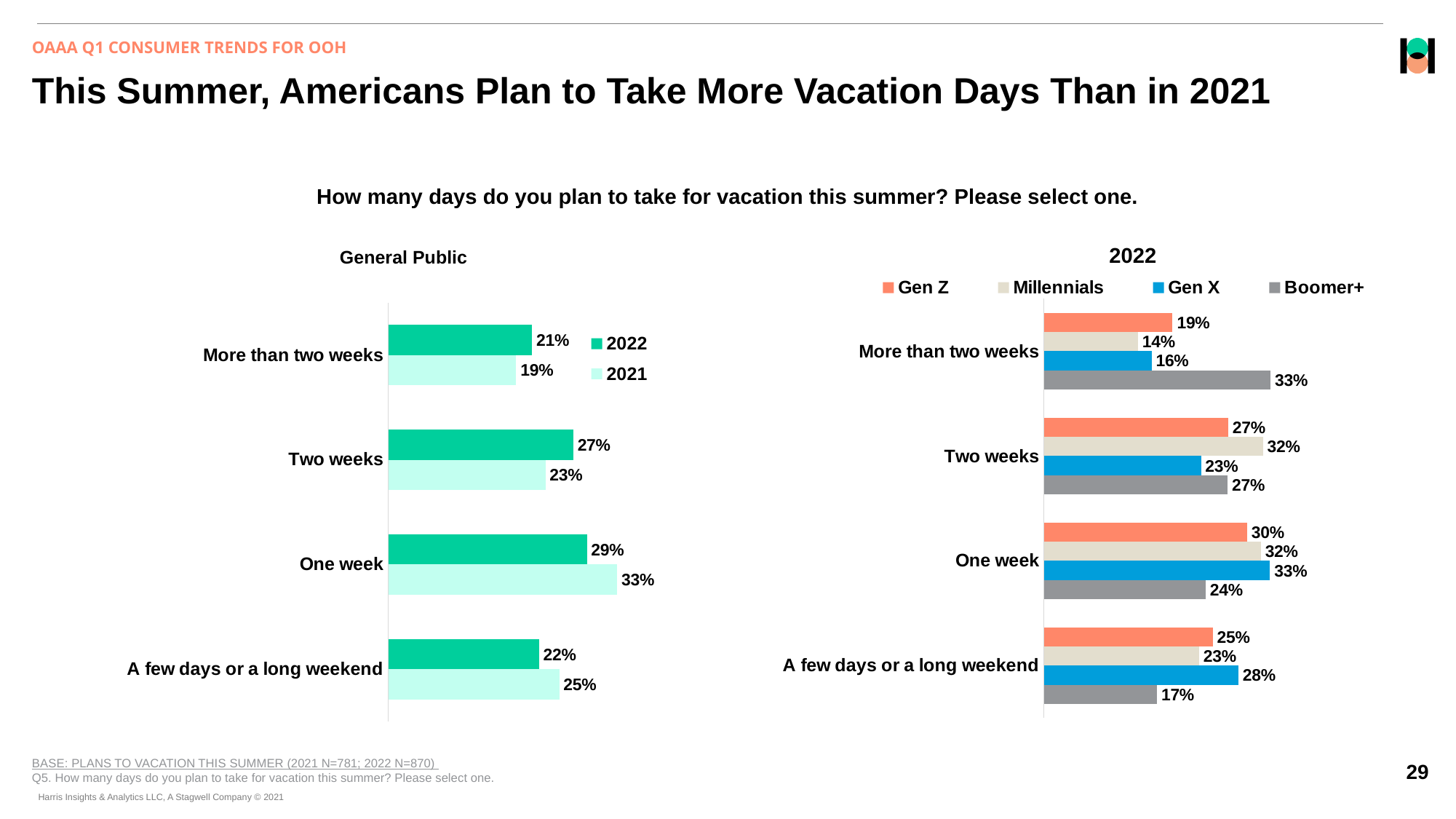
In the General Public chart, what is the difference between the 2022 and 2021 values for Two weeks? 4 percentage points In the 2022 chart, what is the Gen X value for A few days or a long weekend? 28% In the General Public chart, how many series does the legend list? 2 In the 2022 chart, what is the difference between the Gen Z and Boomer+ values for A few days or a long weekend? 8 percentage points In the General Public chart, which category has the highest 2022 value? One week What type of chart is the 2022 chart on the right? Bar chart In the General Public chart, what percentage of respondents in 2022 plan to take more than two weeks of vacation? 21% In the 2022 chart, which generation has the lowest value for More than two weeks? Millennials In the 2022 chart, what percentage of Boomer+ respondents plan to take more than two weeks? 33% In the General Public chart, is the 2022 value or the 2021 value larger for A few days or a long weekend? 2021 In the 2022 chart, how many series does the legend list? 4 In the General Public chart, what was the 2021 value for One week? 33%